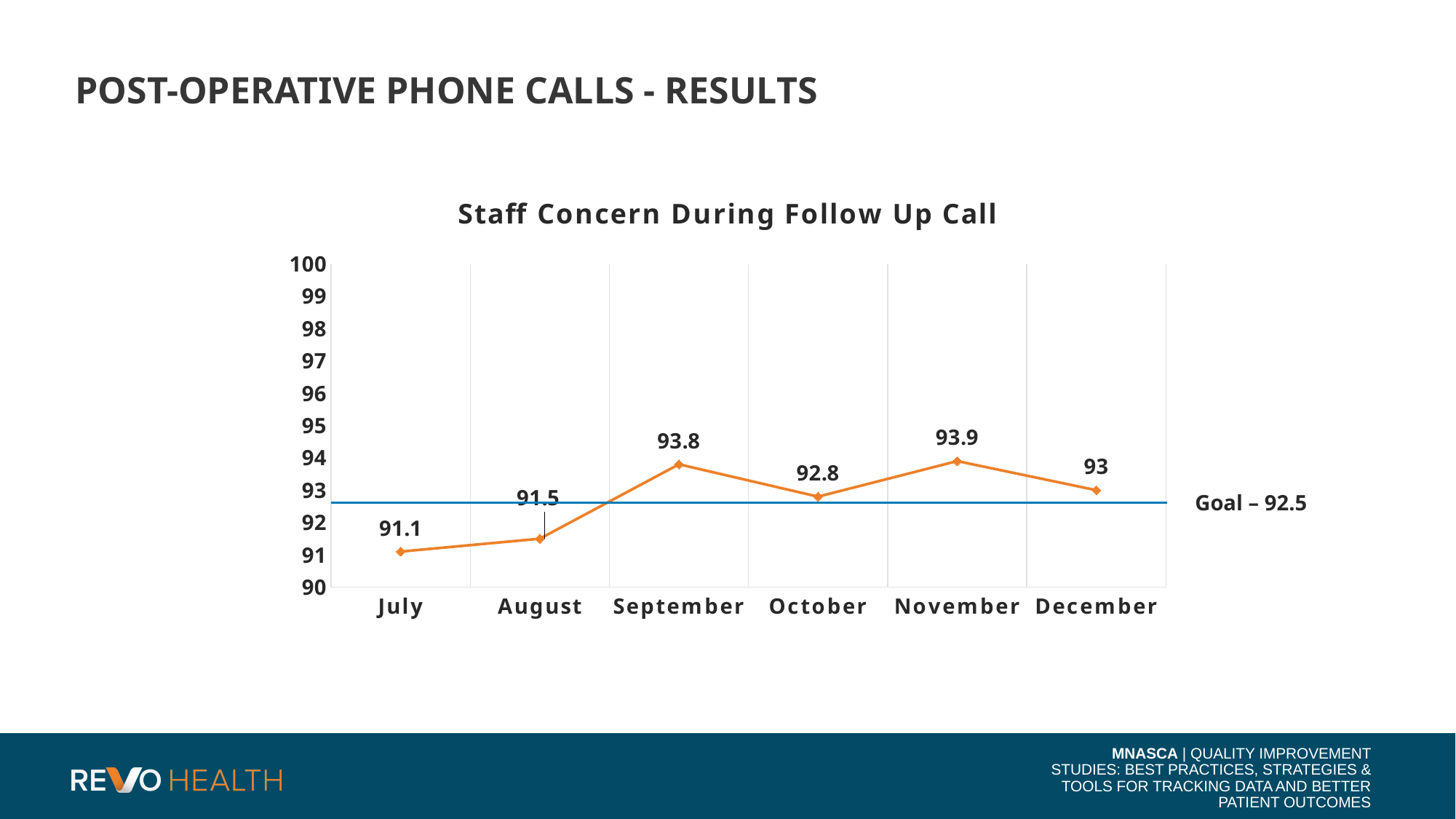
What is the value for September? 93.8 Which is larger, the value for October or the value for August? October What is the value for December? 93 How many months are plotted on the chart? 6 Which month has the lowest value? July What is the difference between the values for November and July? 2.8 What goal value is marked by the horizontal line on the chart? 92.5 Does the value rise or fall from July to September? rise Which month has the highest value? November What kind of chart is shown? line chart Is the value for August greater or less than 92? less What is the value for July? 91.1